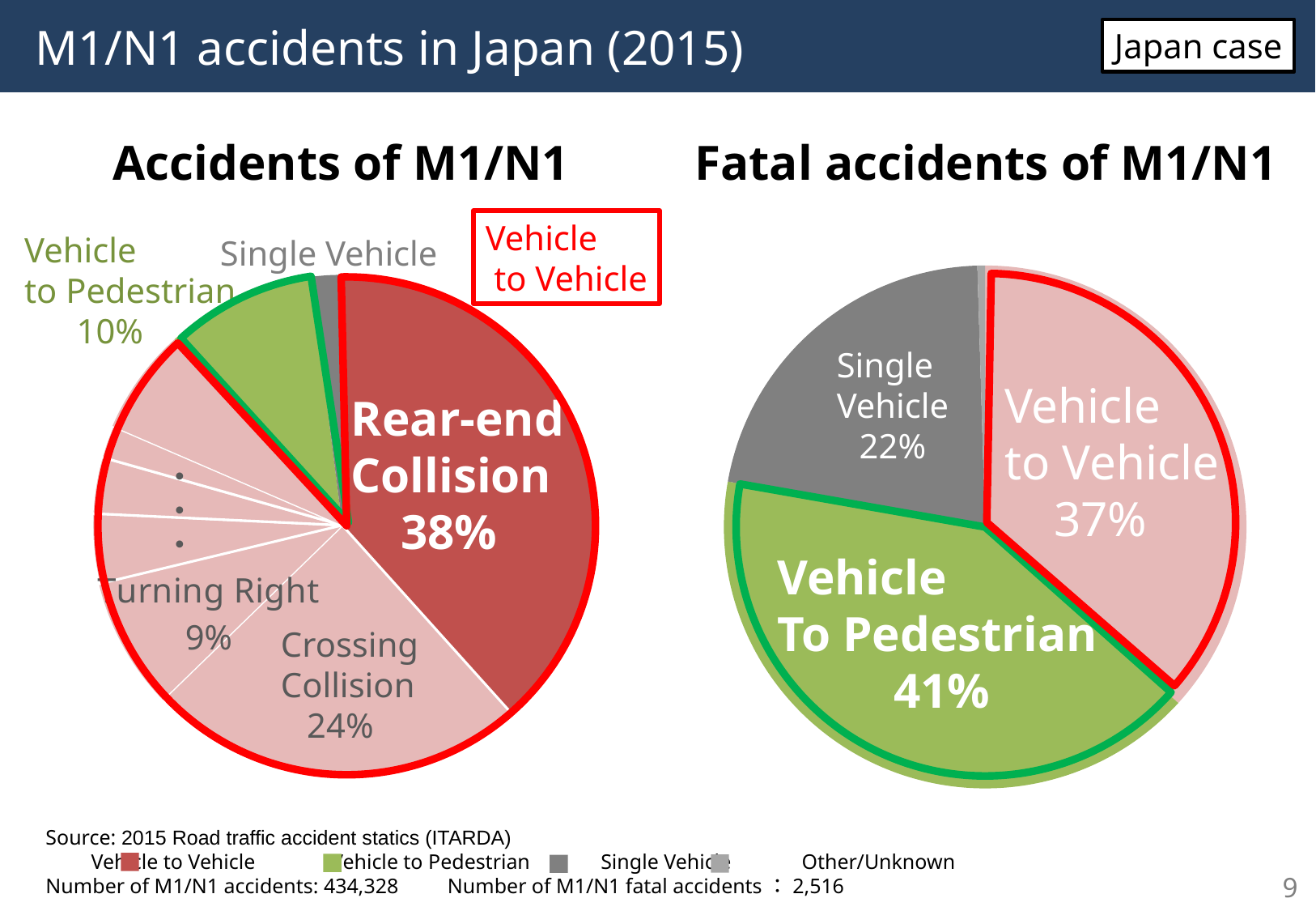
In the 'Accidents of M1/N1' pie chart, what share is shown for Rear-end Collision? 38% In the 'Fatal accidents of M1/N1' pie chart, what share is shown for Vehicle to Vehicle? 37% What kind of chart is used for 'Fatal accidents of M1/N1'? Pie chart In the 'Accidents of M1/N1' pie chart, which is larger: Rear-end Collision or Crossing Collision? Rear-end Collision How many categories does the legend at the bottom of the slide list? 4 In the 'Fatal accidents of M1/N1' pie chart, what share is shown for Vehicle To Pedestrian? 41% In the 'Fatal accidents of M1/N1' pie chart, what share is shown for Single Vehicle? 22% In the 'Accidents of M1/N1' pie chart, what share is shown for Vehicle to Pedestrian? 10% In the 'Fatal accidents of M1/N1' pie chart, how many percentage points larger is Vehicle To Pedestrian than Single Vehicle? 19 percentage points In the 'Fatal accidents of M1/N1' pie chart, which labelled slice is the largest? Vehicle To Pedestrian In the 'Accidents of M1/N1' pie chart, what share is shown for Turning Right? 9% In the 'Accidents of M1/N1' pie chart, what share is shown for Crossing Collision? 24%